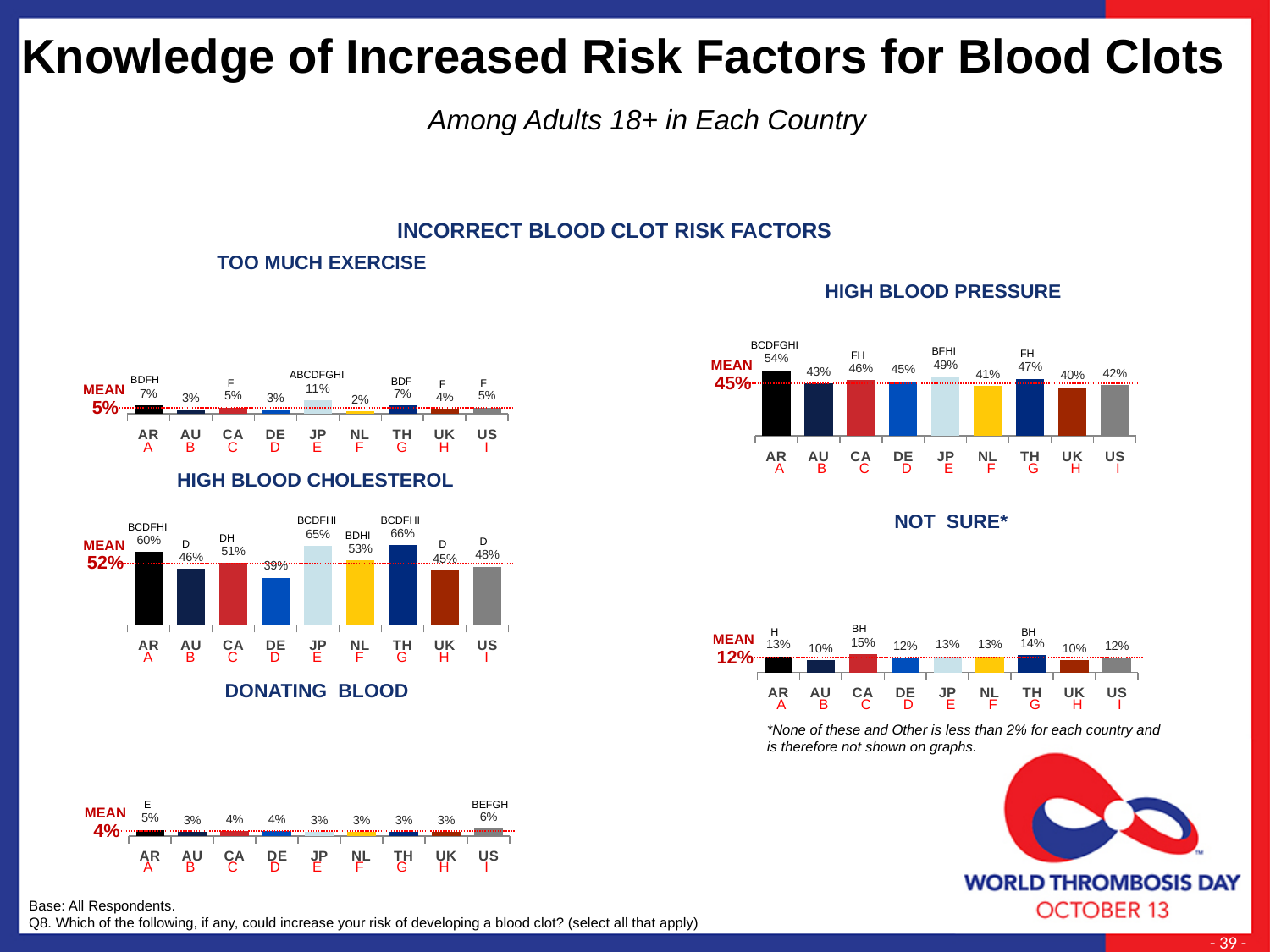
In the NOT SURE chart, which country has the highest value? CA In the HIGH BLOOD CHOLESTEROL chart, what is the difference between the values for TH and DE? 27% In the NOT SURE chart, what is the difference between the values for CA and UK? 5% In the TOO MUCH EXERCISE chart, what is the value for JP? 11% In the TOO MUCH EXERCISE chart, which country has the lowest value? NL In the DONATING BLOOD chart, what is the mean value shown? 4% In the HIGH BLOOD CHOLESTEROL chart, which country has the highest value? TH In the HIGH BLOOD CHOLESTEROL chart, what is the value for DE? 39% In the HIGH BLOOD PRESSURE chart, what is the value for AR? 54% How many countries are shown in the HIGH BLOOD PRESSURE chart? 9 In the DONATING BLOOD chart, which country has the highest value? US In the HIGH BLOOD PRESSURE chart, which is larger, the value for JP or the value for NL? JP